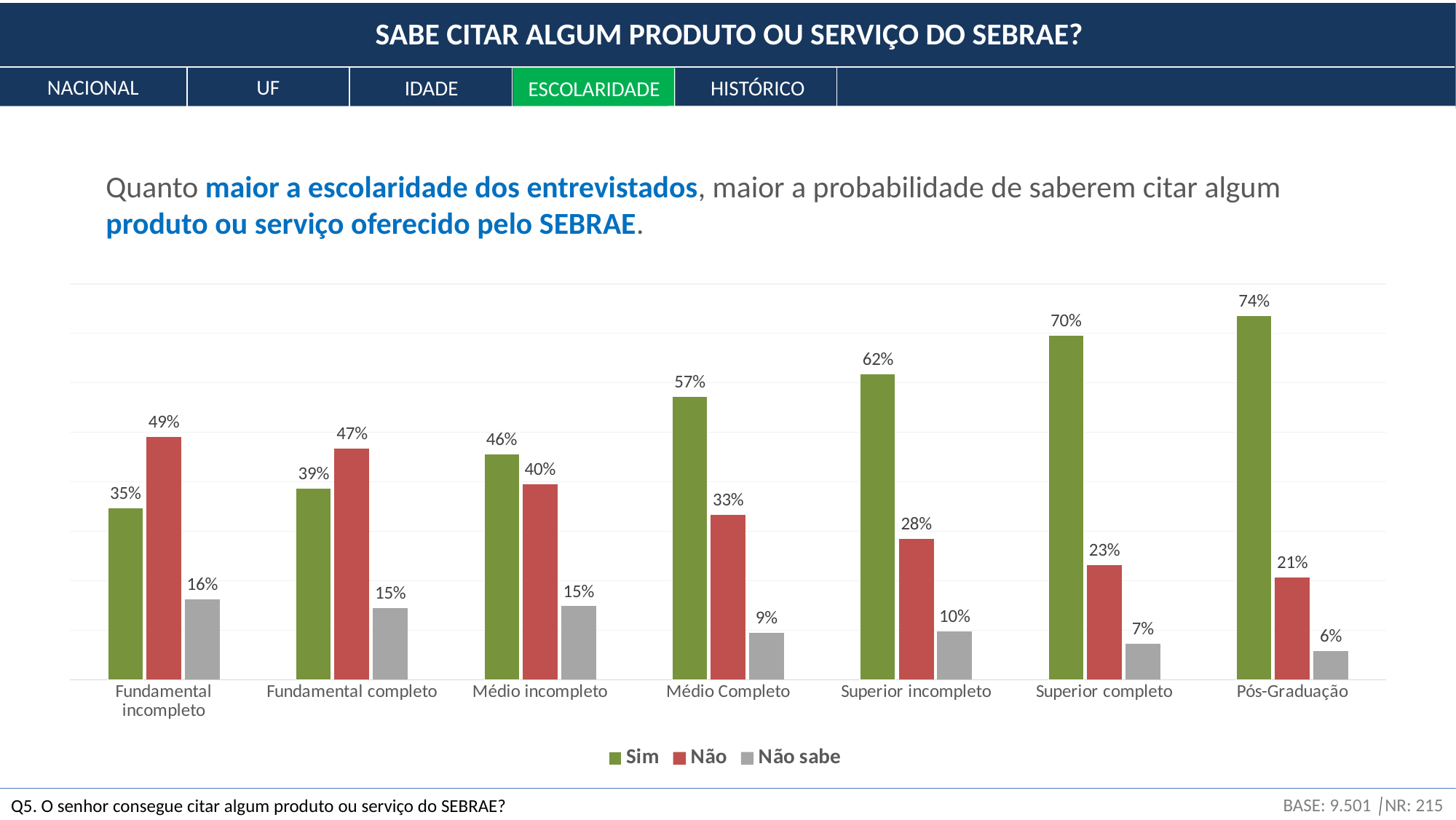
Which colour represents the "Não" series in the legend? Red What is the value of "Não" for Fundamental incompleto? 49% Which category has the highest "Sim" value? Pós-Graduação What is the difference between the "Sim" values for Superior completo and Fundamental incompleto? 35% How many series does the legend list? 3 How many education categories are shown on the x axis? 7 Which category has the lowest "Não sabe" value? Pós-Graduação Do the "Sim" values rise or fall from Fundamental incompleto to Pós-Graduação? Rise Which is larger for Médio incompleto: "Sim" or "Não"? Sim What is the value of "Sim" for Pós-Graduação? 74% What kind of chart is shown on the slide? Bar chart What is the value of "Não sabe" for Médio Completo? 9%